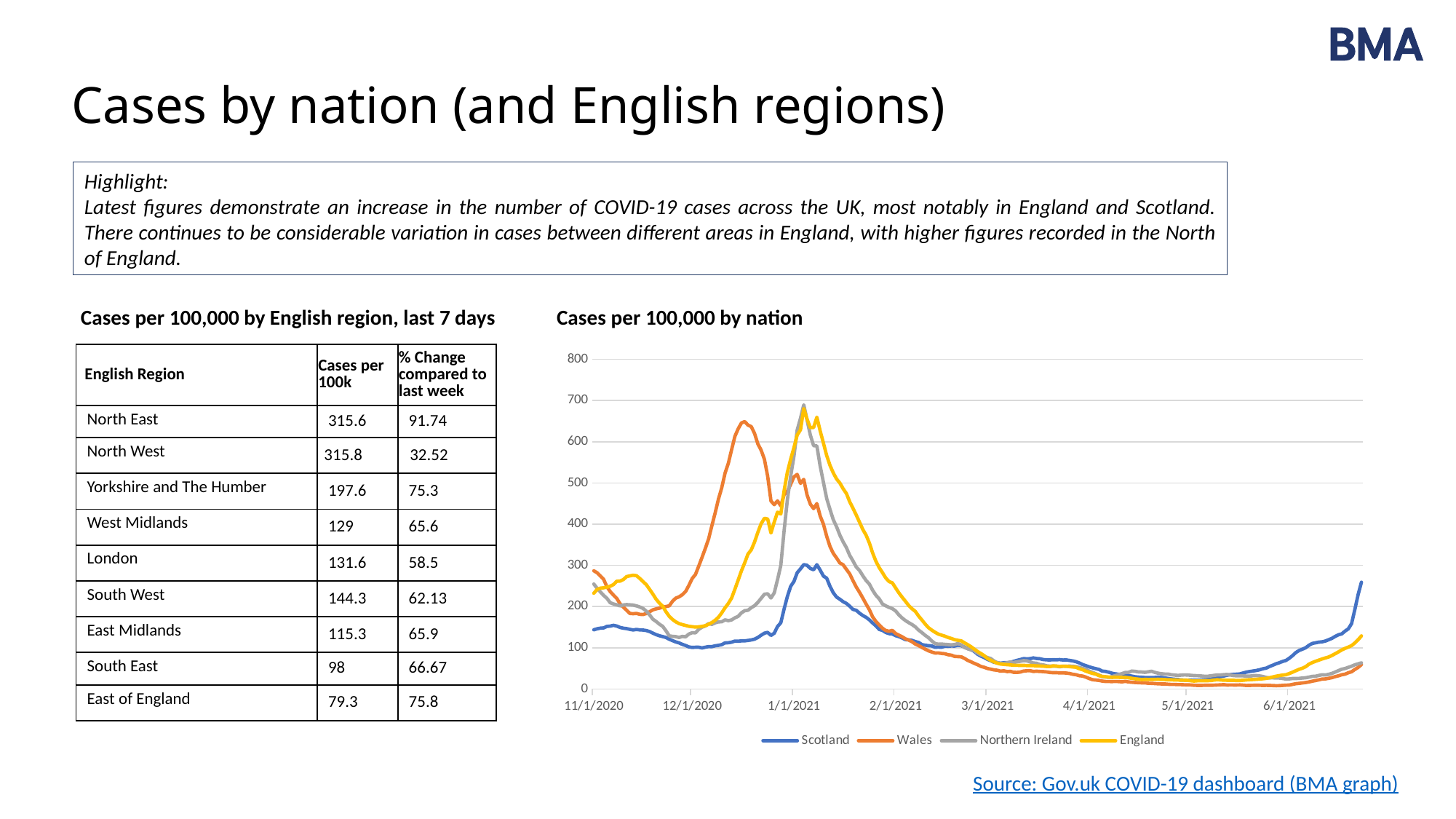
How many series does the legend of the 'Cases per 100,000 by nation' chart list? 4 In the 'Cases per 100,000 by nation' chart, which nation reaches its peak earliest? Wales In the 'Cases per 100,000 by nation' chart, is the peak value for Wales in December 2020 greater or less than 600? greater In the 'Cases per 100,000 by nation' chart, is the peak value for Scotland in January 2021 greater or less than 400? less Which nations are listed in the legend of the 'Cases per 100,000 by nation' chart? Scotland, Wales, Northern Ireland, England In the 'Cases per 100,000 by nation' chart, do the values for Scotland rise or fall between 5/1/2021 and the end of the chart? rise What kind of chart is 'Cases per 100,000 by nation'? line chart In the 'Cases per 100,000 by nation' chart, is the value for Wales at 4/1/2021 greater or less than 100? less In the 'Cases per 100,000 by nation' chart, at 12/1/2020 is the value for Wales or Scotland larger? Wales In the 'Cases per 100,000 by nation' chart, do the values for England rise or fall between 2/1/2021 and 3/1/2021? fall In the 'Cases per 100,000 by nation' chart, which nation has the lowest peak over the whole period? Scotland